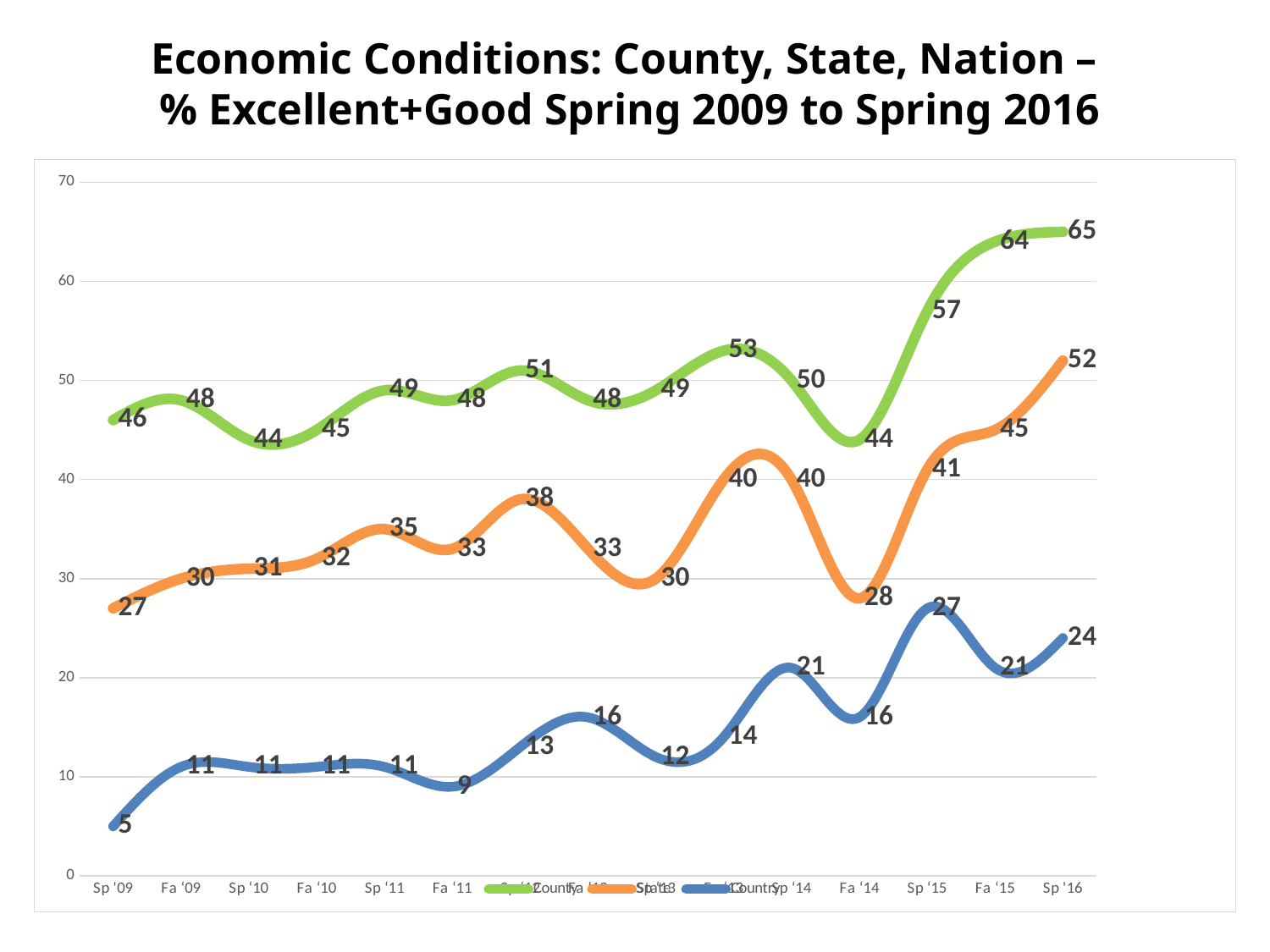
How many series does the legend list? 3 At which period is the Country series at its highest? Sp '15 Is the County value for Fa '15 greater or less than 60? greater What is the State value for Fa '14? 28 At which period is the County series at its lowest? Sp '10 and Fa '14 (44) What is the County value for Sp '16? 65 Which is larger at Sp '15: the State value or the Country value? State Does the State series rise or fall from Sp '15 to Sp '16? rise How many time periods are plotted along the x axis? 15 What is the difference between the County and State values at Sp '16? 13 What is the Country value for Sp '09? 5 What type of chart is shown on the slide? line chart